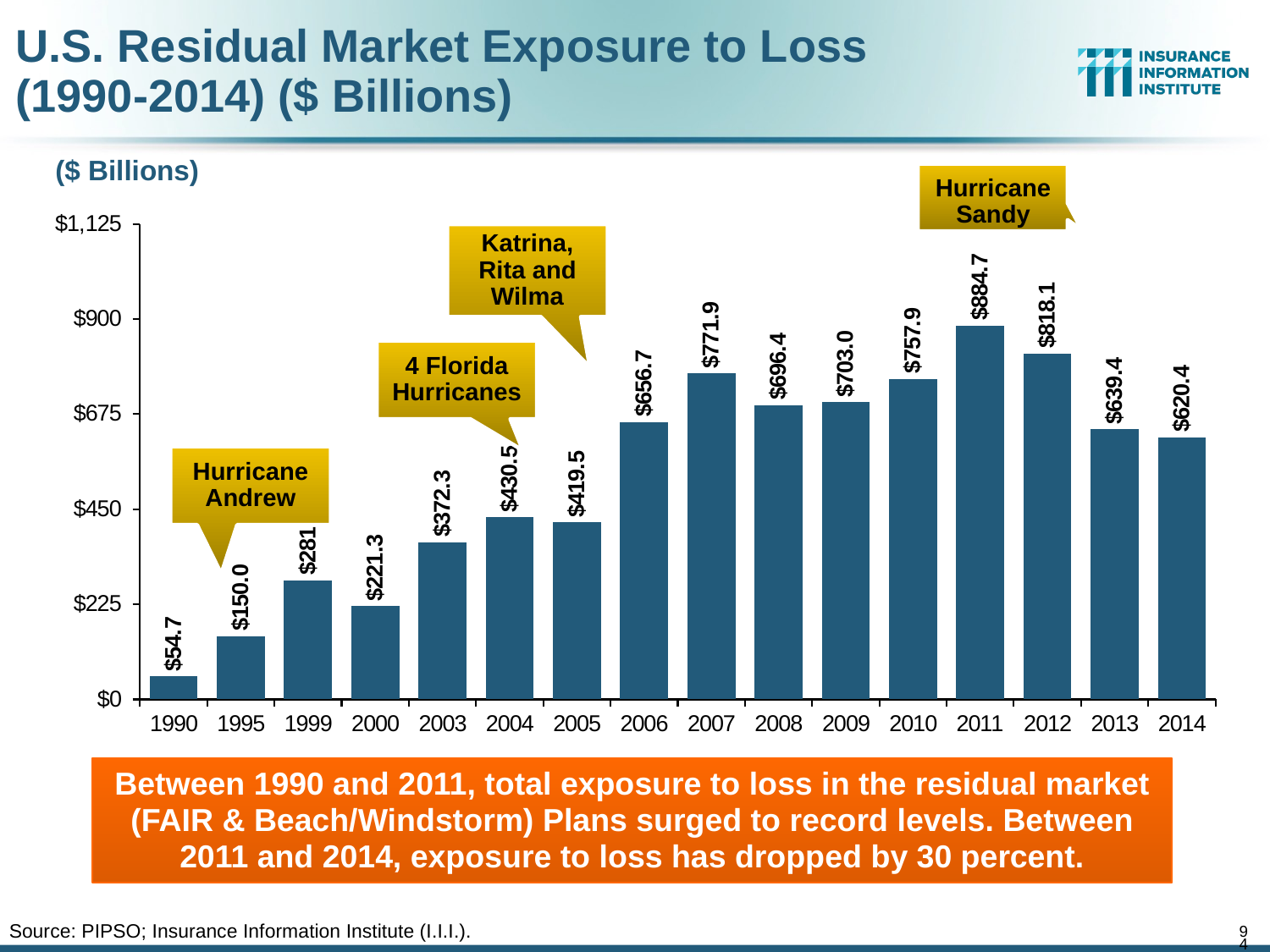
Which hurricane is named in the callout pointing to the 2011 bar? Hurricane Sandy What is the exposure to loss value for 2004? $430.5 Which year has the highest exposure to loss? 2011 Do the values rise or fall from 2011 to 2014? Fall How many years are shown on the x axis? 16 What is the U.S. residual market exposure to loss for 2011? $884.7 What kind of chart is shown on the slide? Bar chart What is the difference between the 2011 value and the 2014 value? $264.3 Which year has the larger value, 2008 or 2009? 2009 Which year has the lowest exposure to loss? 1990 What value is shown for 1990? $54.7 Is the value for 2007 greater or less than $675? greater